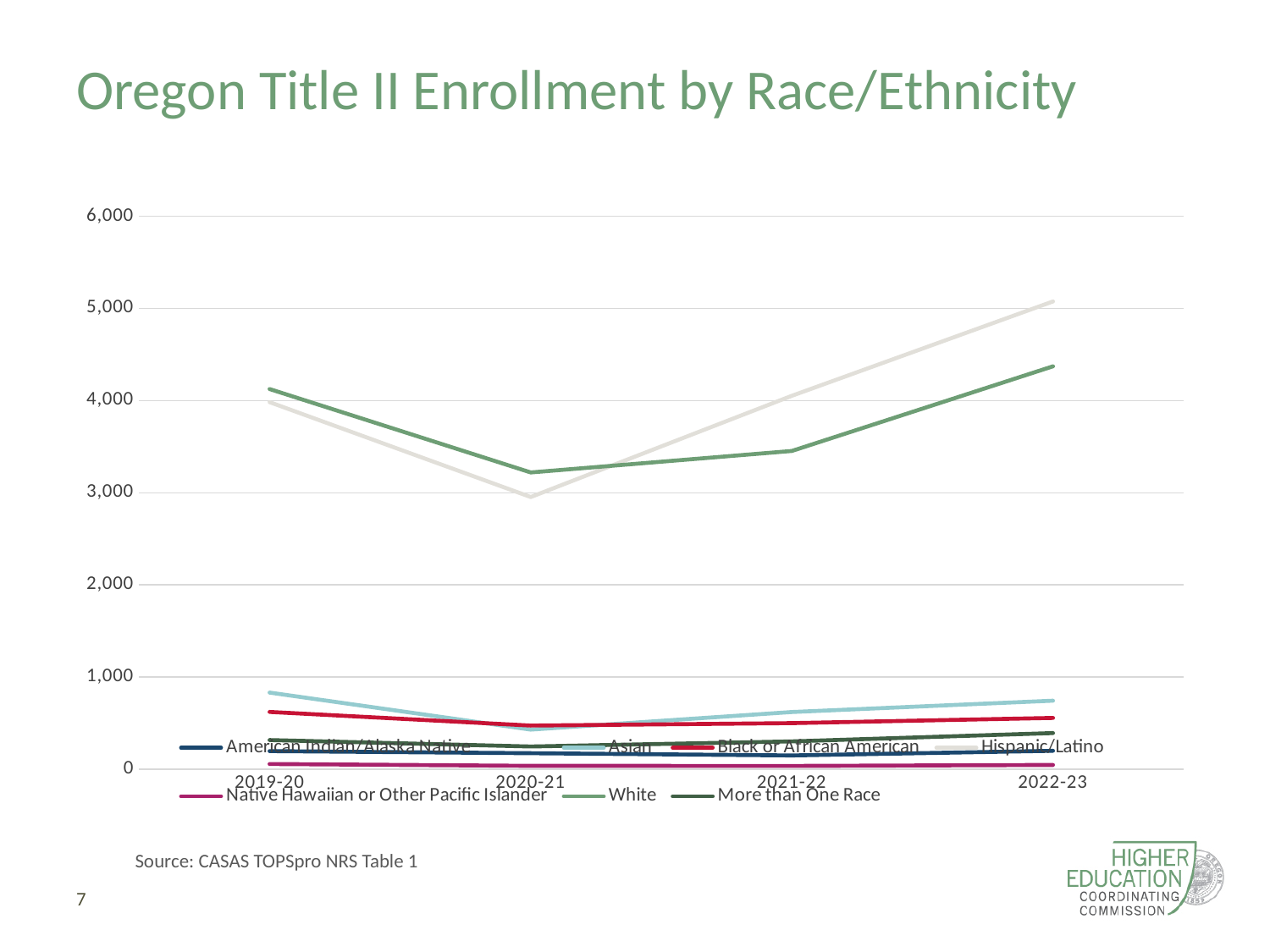
Is the White enrollment in 2019-20 greater or less than 4,000? greater Which race/ethnicity has the lowest enrollment across all years shown? Native Hawaiian or Other Pacific Islander How many program years are shown along the x axis? 4 In 2019-20, which is larger: White enrollment or Hispanic/Latino enrollment? White In 2021-22, which is larger: Asian enrollment or Black or African American enrollment? Asian How does Hispanic/Latino enrollment change from 2020-21 to 2022-23? It rises Which race/ethnicity has the highest enrollment in 2022-23? Hispanic/Latino What is the title of the chart? Oregon Title II Enrollment by Race/Ethnicity Is the Hispanic/Latino enrollment in 2020-21 greater or less than 3,000? less What kind of chart is shown on the slide? line chart How many series does the legend list? 7 Is the Hispanic/Latino enrollment in 2022-23 greater or less than 5,000? greater